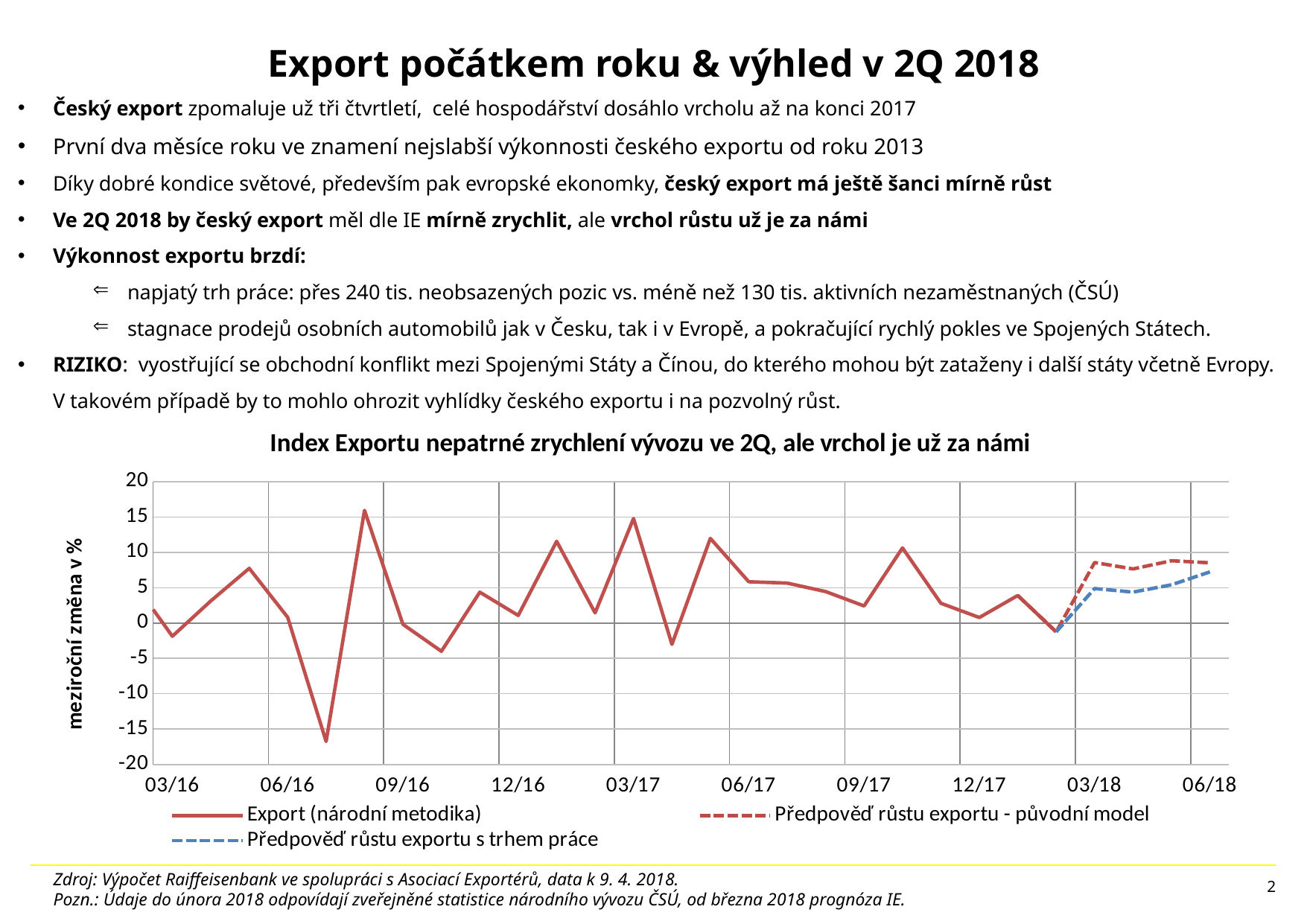
Is the value of the Předpověď růstu exportu - původní model line at 06/18 greater or less than 5? greater Which is larger for the Export (národní metodika) line: the value at 03/17 or the value at 06/17? 03/17 How many series does the chart legend list? 3 Is the value of the Export (národní metodika) line at 06/17 greater or less than 0? greater Is the lowest value of the Export (národní metodika) line greater or less than -15? less Does the Předpověď růstu exportu s trhem práce line rise or fall between 03/18 and 06/18? rise At 06/18, which forecast line is higher: Předpověď růstu exportu - původní model or Předpověď růstu exportu s trhem práce? Předpověď růstu exportu - původní model What is the label of the vertical axis of the chart? meziroční změna v % What type of chart is shown on the slide? line chart What is the title of the chart? Index Exportu nepatrné zrychlení vývozu ve 2Q, ale vrchol je už za námi